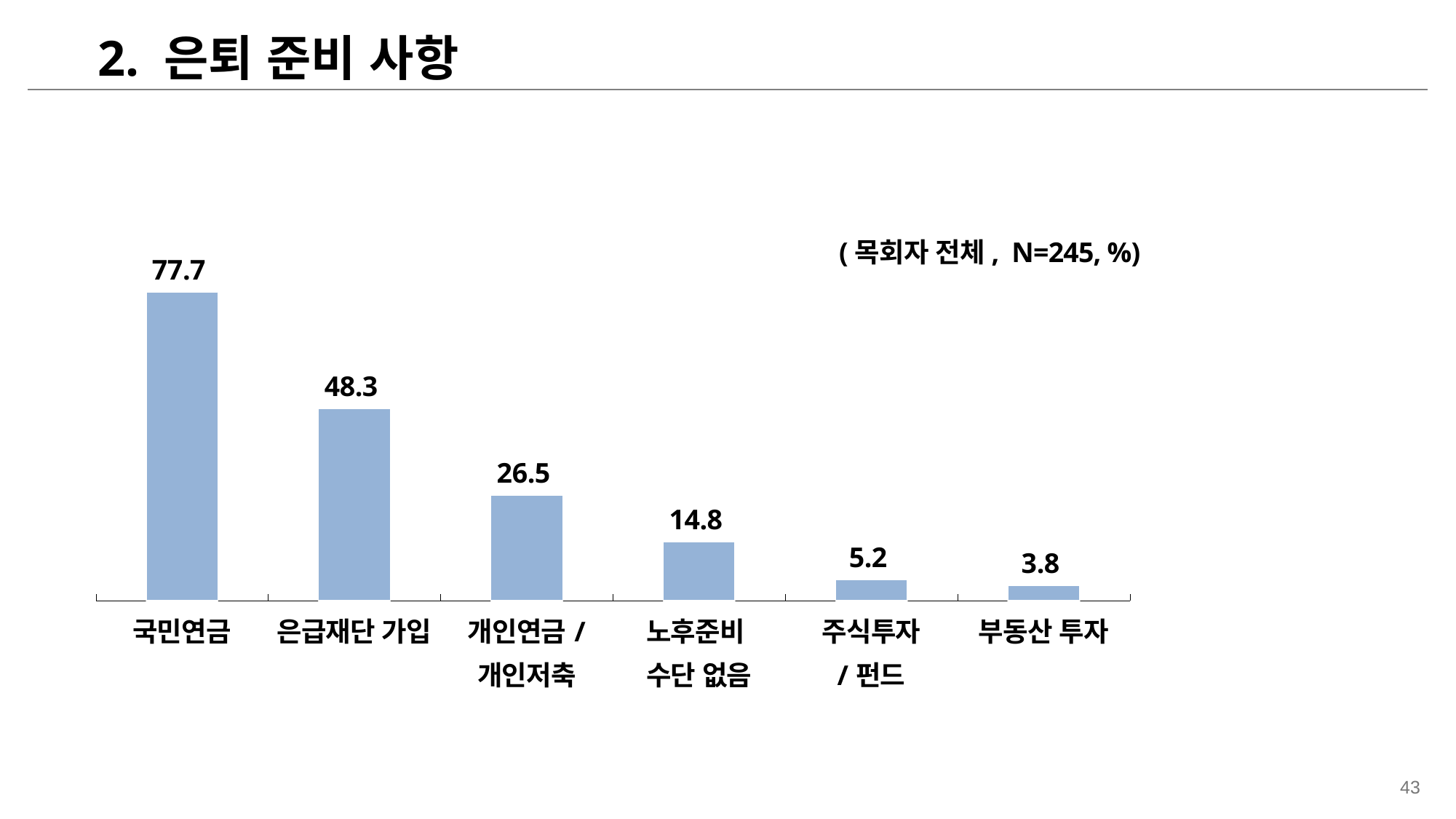
What is the sample size (N) noted on the chart? N=245 What is the value for 개인연금 / 개인저축? 26.5 What is the value for 국민연금? 77.7 Which category has the highest value? 국민연금 What is the difference between the values for 국민연금 and 은급재단 가입? 29.4 How many categories are shown in the chart? 6 What is the value for 은급재단 가입? 48.3 What kind of chart is shown on the slide? Bar chart Which category has the lowest value? 부동산 투자 What is the value for 부동산 투자? 3.8 What is the value for 노후준비 수단 없음? 14.8 Which is larger, the value for 주식투자 / 펀드 or the value for 부동산 투자? 주식투자 / 펀드